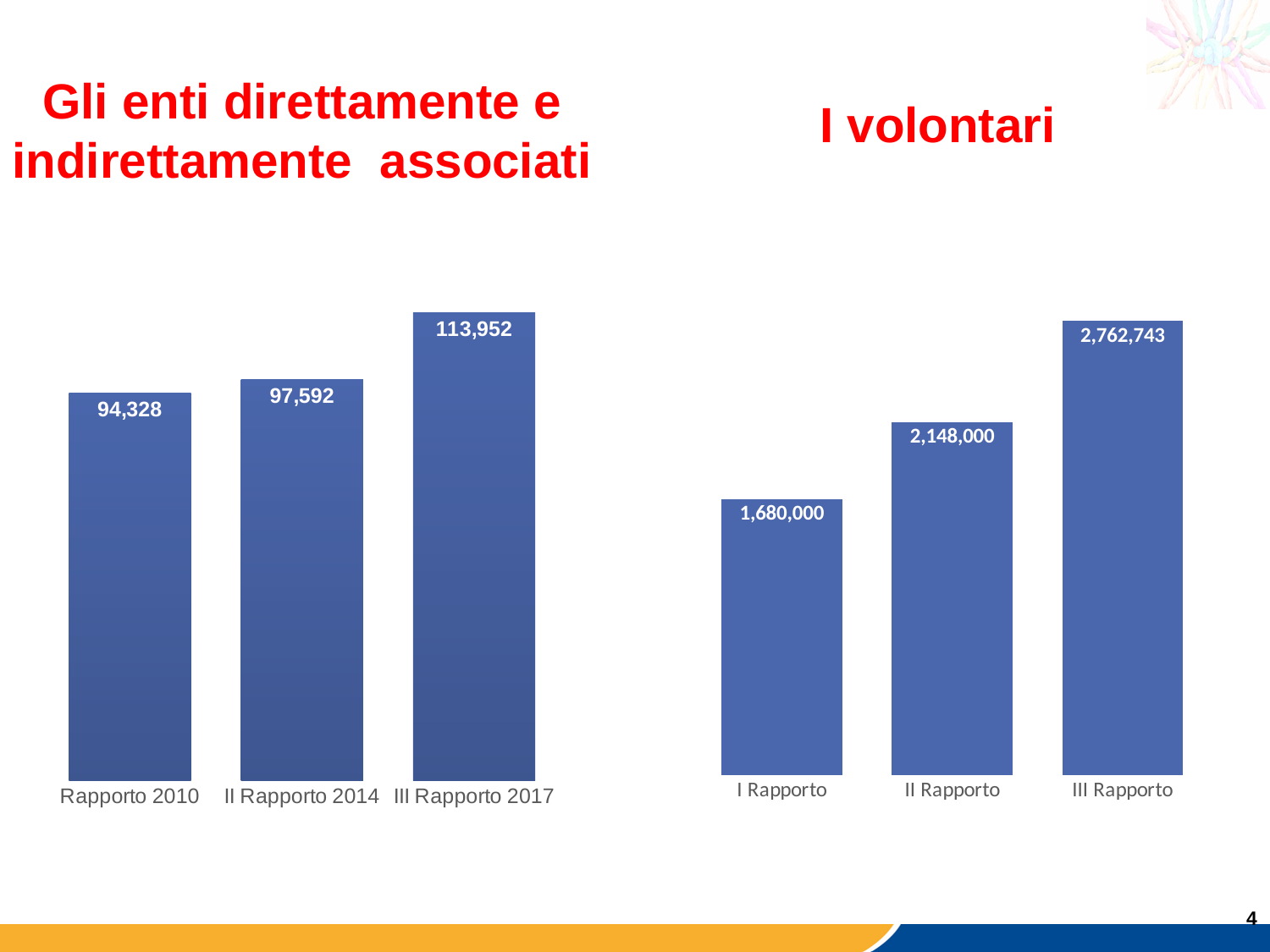
In the 'I volontari' chart, what is the difference between II Rapporto and I Rapporto? 468,000 What kind of chart is the 'I volontari' chart? bar chart In the 'I volontari' chart, do the values rise or fall from I Rapporto to III Rapporto? rise In the 'Gli enti direttamente e indirettamente associati' chart, what is the value for Rapporto 2010? 94,328 In the 'I volontari' chart, which category has the lowest value? I Rapporto In the 'I volontari' chart, what is the value for III Rapporto? 2,762,743 In the 'Gli enti direttamente e indirettamente associati' chart, which is larger: Rapporto 2010 or II Rapporto 2014? II Rapporto 2014 In the 'Gli enti direttamente e indirettamente associati' chart, what is the value for II Rapporto 2014? 97,592 In the 'Gli enti direttamente e indirettamente associati' chart, which category has the highest value? III Rapporto 2017 In the 'I volontari' chart, what is the value for II Rapporto? 2,148,000 In the 'Gli enti direttamente e indirettamente associati' chart, what is the difference between III Rapporto 2017 and Rapporto 2010? 19,624 In the 'Gli enti direttamente e indirettamente associati' chart, how many bars are shown? 3